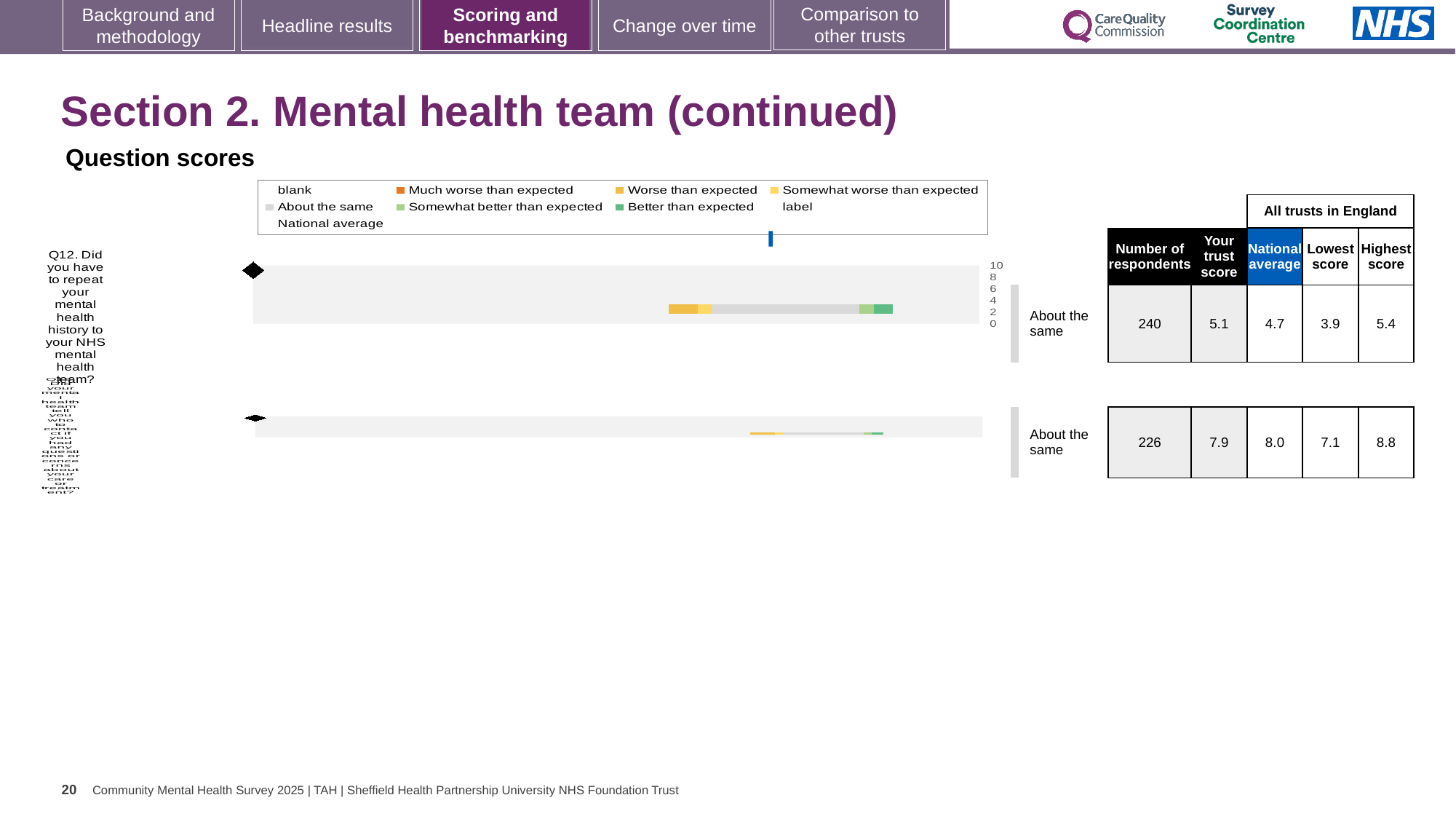
What is the lowest score among all trusts in England for Q12? 3.9 How many respondents are listed for Q12 in the table beside the chart? 240 How many questions are plotted as bars in the question scores chart? 2 For Q12, what is the difference between the highest score and the lowest score among all trusts in England? 1.5 In the chart legend, what colour represents "Better than expected"? green What is the national average score for Q12? 4.7 For Q12, is the trust score higher or lower than the national average? higher What benchmark category is shown next to the bar for Q12? About the same What kind of chart is used to show the question scores on this slide? bar chart In the chart legend, what colour represents "Much worse than expected"? orange What is the trust score for Q12? 5.1 What is the highest score among all trusts in England for Q12? 5.4